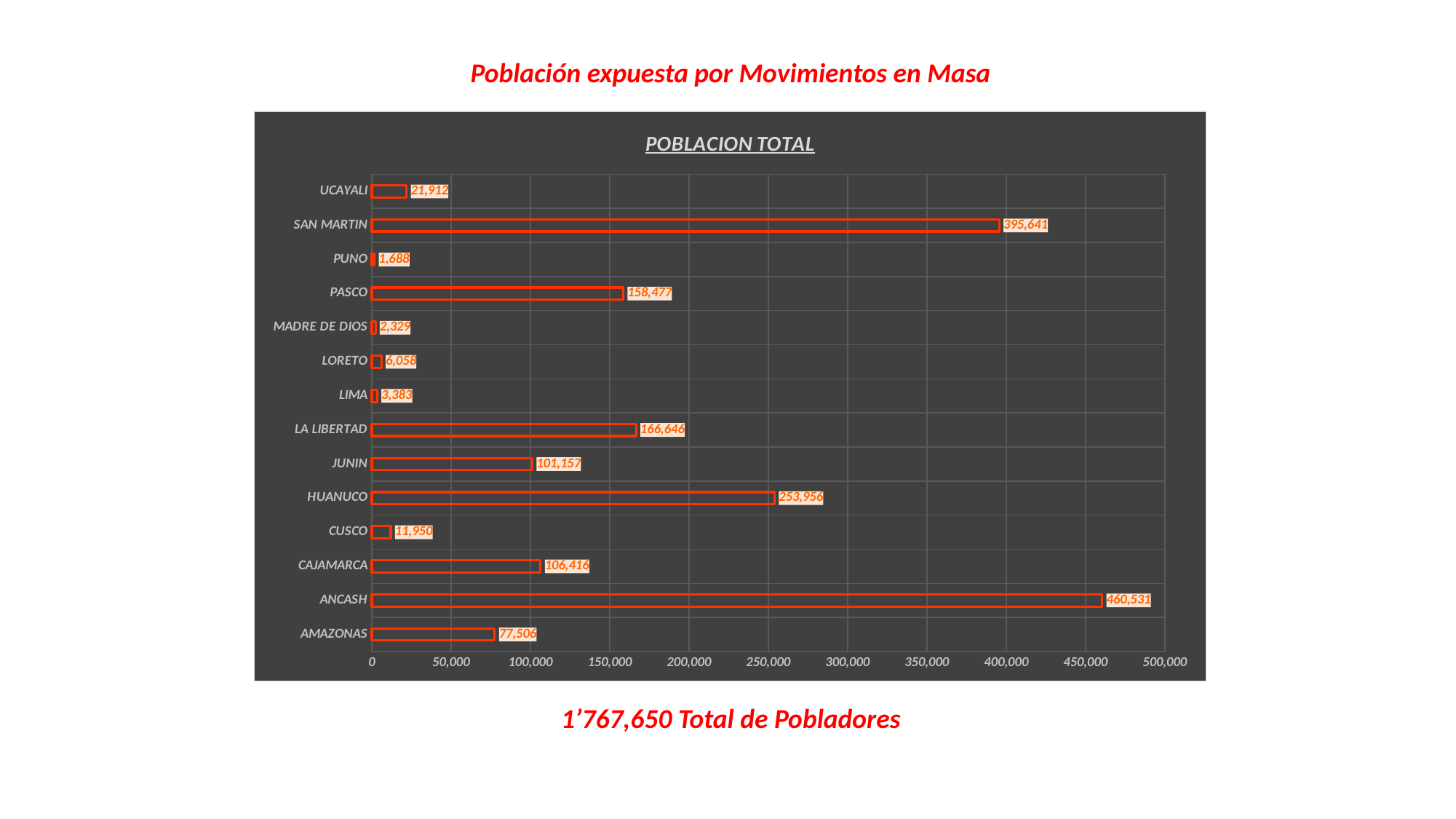
Which category has the highest value? ANCASH What is the title of the chart? POBLACION TOTAL What is the difference between the values for ANCASH and SAN MARTIN? 64,890 How many categories are shown in the chart? 14 Which is larger, the value for CAJAMARCA or the value for JUNIN? CAJAMARCA What is the value for SAN MARTIN? 395,641 Is the value for HUANUCO greater or less than 200,000? greater What is the value for HUANUCO? 253,956 What is the value for AMAZONAS? 77,506 Which category has the lowest value? PUNO What is the difference between the values for LA LIBERTAD and PASCO? 8,169 What kind of chart is shown on the slide? bar chart